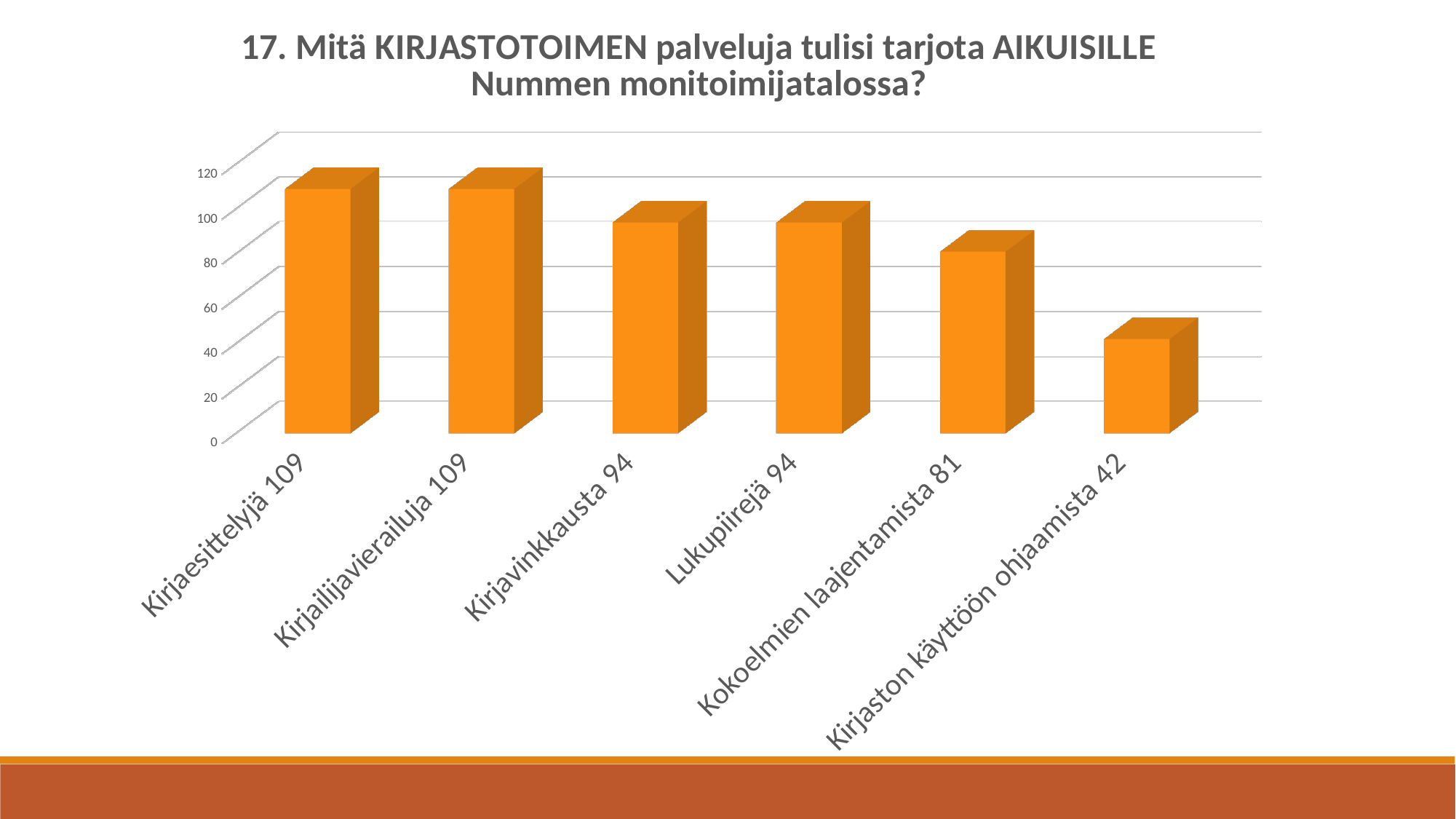
What is the difference between the values for Kirjaesittelyjä and Kirjaston käyttöön ohjaamista? 67 Do the values rise or fall from left to right along the x axis? fall What is the value for Kirjavinkkausta? 94 What is the value for Kirjaston käyttöön ohjaamista? 42 What is the value for Kokoelmien laajentamista? 81 Which category has the lowest value? Kirjaston käyttöön ohjaamista What is the difference between the values for Lukupiirejä and Kokoelmien laajentamista? 13 Which is larger, the value for Kirjailijavierailuja or the value for Lukupiirejä? Kirjailijavierailuja What is the value for Kirjaesittelyjä? 109 What kind of chart is shown on the slide? bar chart Is the value for Kokoelmien laajentamista greater or less than 100? less How many categories are shown in the chart? 6